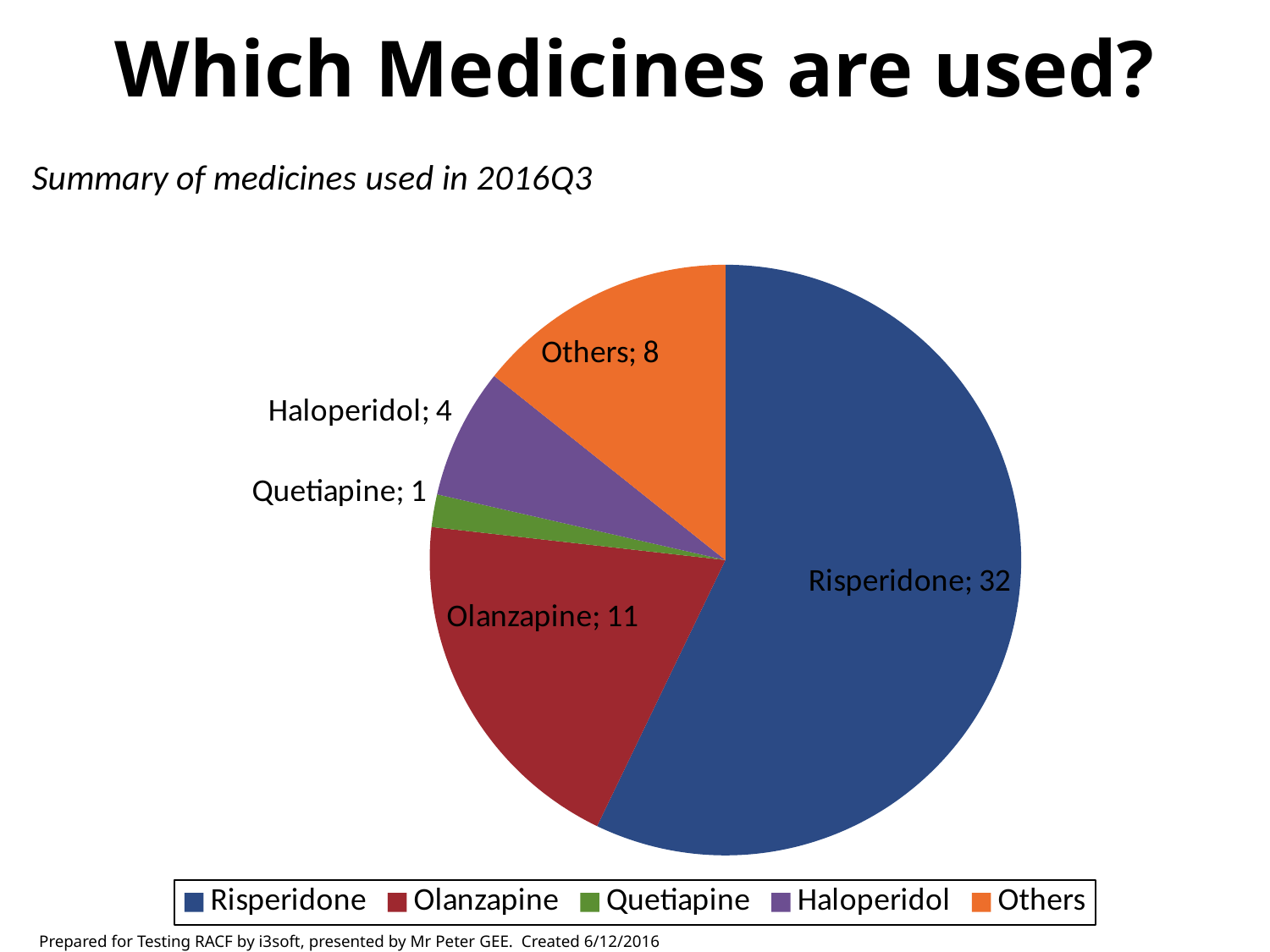
What is the subtitle shown above the chart? Summary of medicines used in 2016Q3 Which is larger, the value for Others or the value for Haloperidol? Others Which medicine has the smallest slice of the pie? Quetiapine What is the value for Haloperidol? 4 Which medicine has the largest slice of the pie? Risperidone What is the value for Others? 8 What is the difference between the values for Risperidone and Olanzapine? 21 What is the value for Olanzapine? 11 What type of chart is shown on the slide? Pie chart What is the value for Risperidone? 32 How many slices does the pie chart have? 5